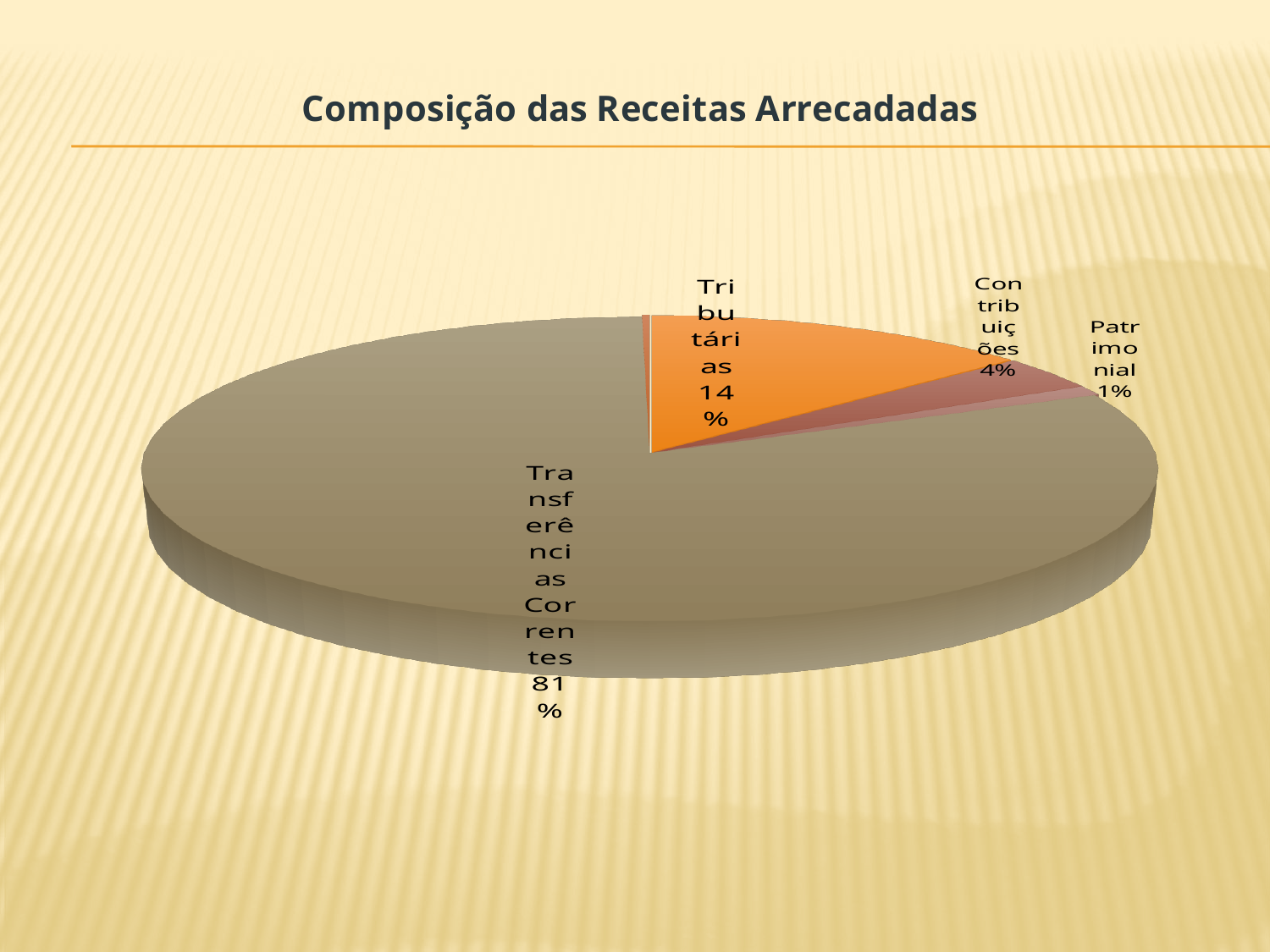
What is the difference in percentage points between Transferências Correntes and Tributárias? 67 What share of the pie is Tributárias? 14% What is the combined share of Contribuições and Patrimonial? 5% What is the title of the chart? Composição das Receitas Arrecadadas What share of the pie is Patrimonial? 1% Which is larger, Tributárias or Contribuições? Tributárias What share of the pie is Transferências Correntes? 81% Which slice is the largest? Transferências Correntes What kind of chart is shown on the slide? pie chart